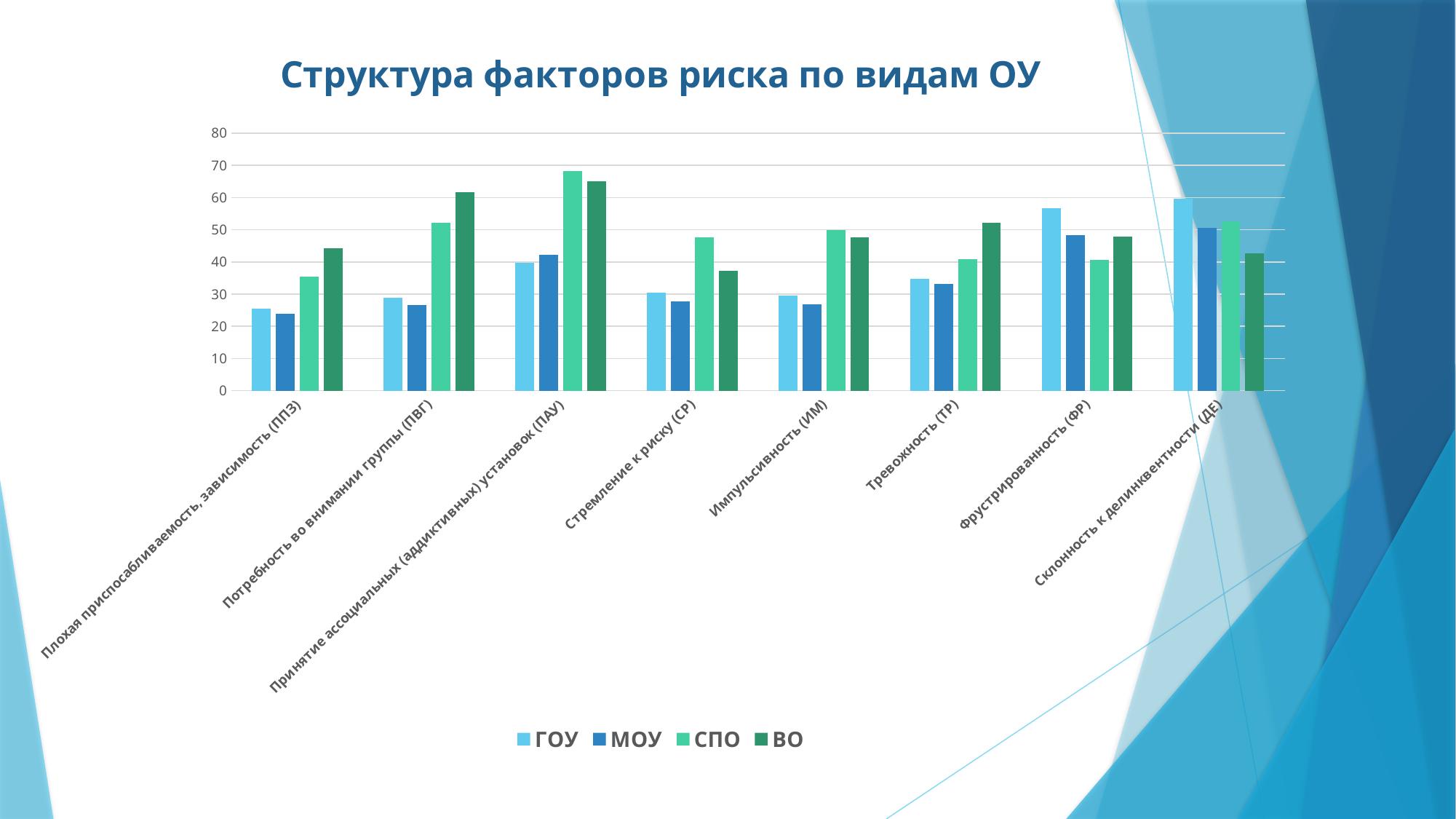
Which category has the lowest value for the ГОУ series? Плохая приспосабливаемость, зависимость (ППЗ) What is the title of the chart? Структура факторов риска по видам ОУ Is the value of МОУ for Плохая приспосабливаемость, зависимость (ППЗ) greater or less than 30? less Which category has the highest value for the СПО series? Принятие ассоциальных (аддиктивных) установок (ПАУ) How many series does the legend list? 4 Is the value of ВО for Потребность во внимании группы (ПВГ) greater or less than 50? greater For Принятие ассоциальных (аддиктивных) установок (ПАУ), which is larger: СПО or ГОУ? СПО What kind of chart is shown on the slide? bar chart Is the value of СПО for Импульсивность (ИМ) greater or less than 40? greater How many categories are shown on the x axis? 8 Which series has the highest value for Тревожность (ТР)? ВО For Фрустрированность (ФР), which is larger: ГОУ or СПО? ГОУ